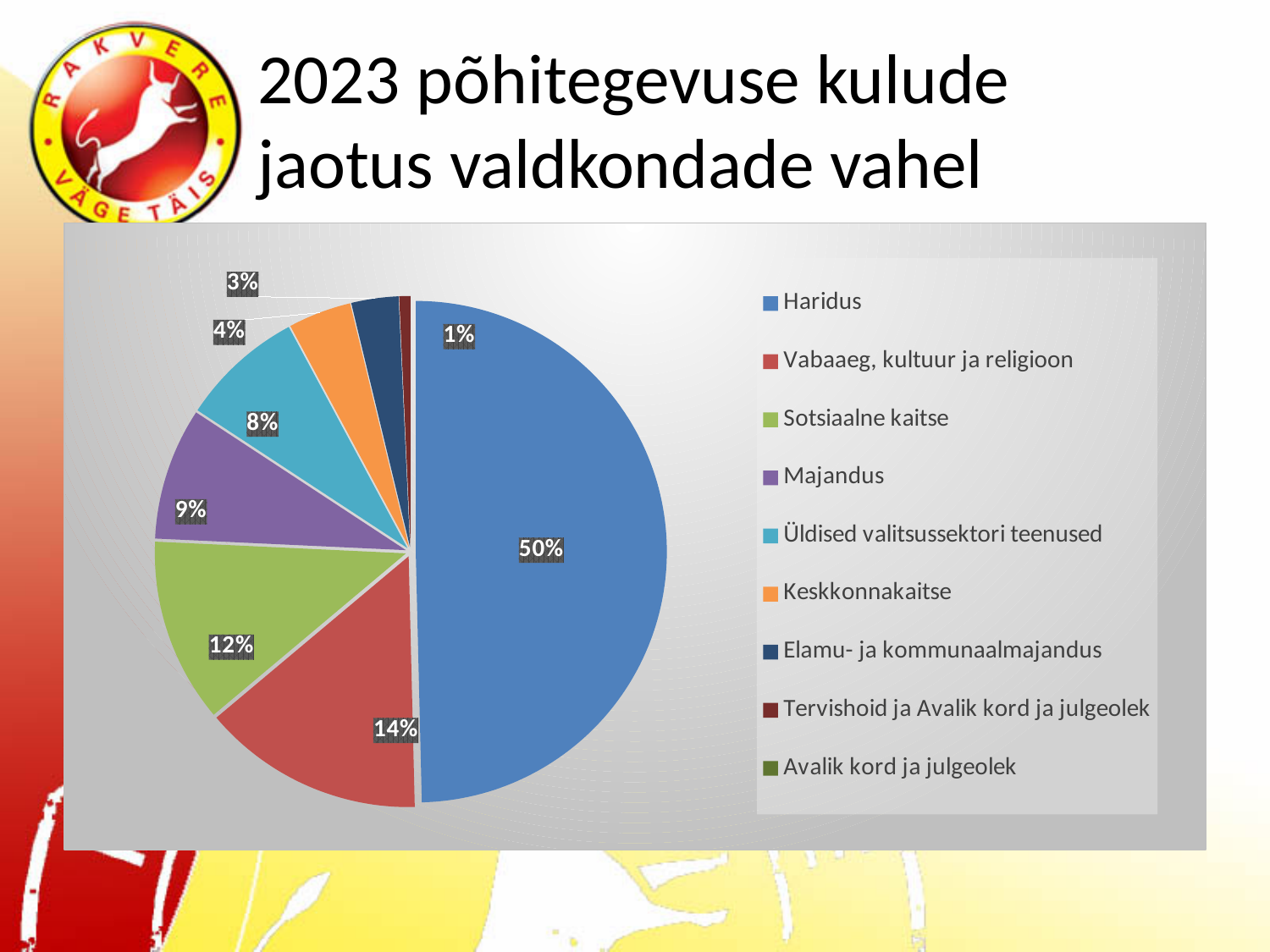
How many categories does the legend list? 9 Which category has the largest slice of the pie? Haridus What kind of chart is shown on the slide? pie chart What share of the pie does Keskkonnakaitse have? 4% What share of the pie does Vabaaeg, kultuur ja religioon have? 14% Which is larger, the slice for Sotsiaalne kaitse or the slice for Majandus? Sotsiaalne kaitse What share of the pie does Üldised valitsussektori teenused have? 8% What is the difference in percentage points between the Haridus slice and the Vabaaeg, kultuur ja religioon slice? 36 What is the title of the slide containing the pie chart? 2023 põhitegevuse kulude jaotus valdkondade vahel